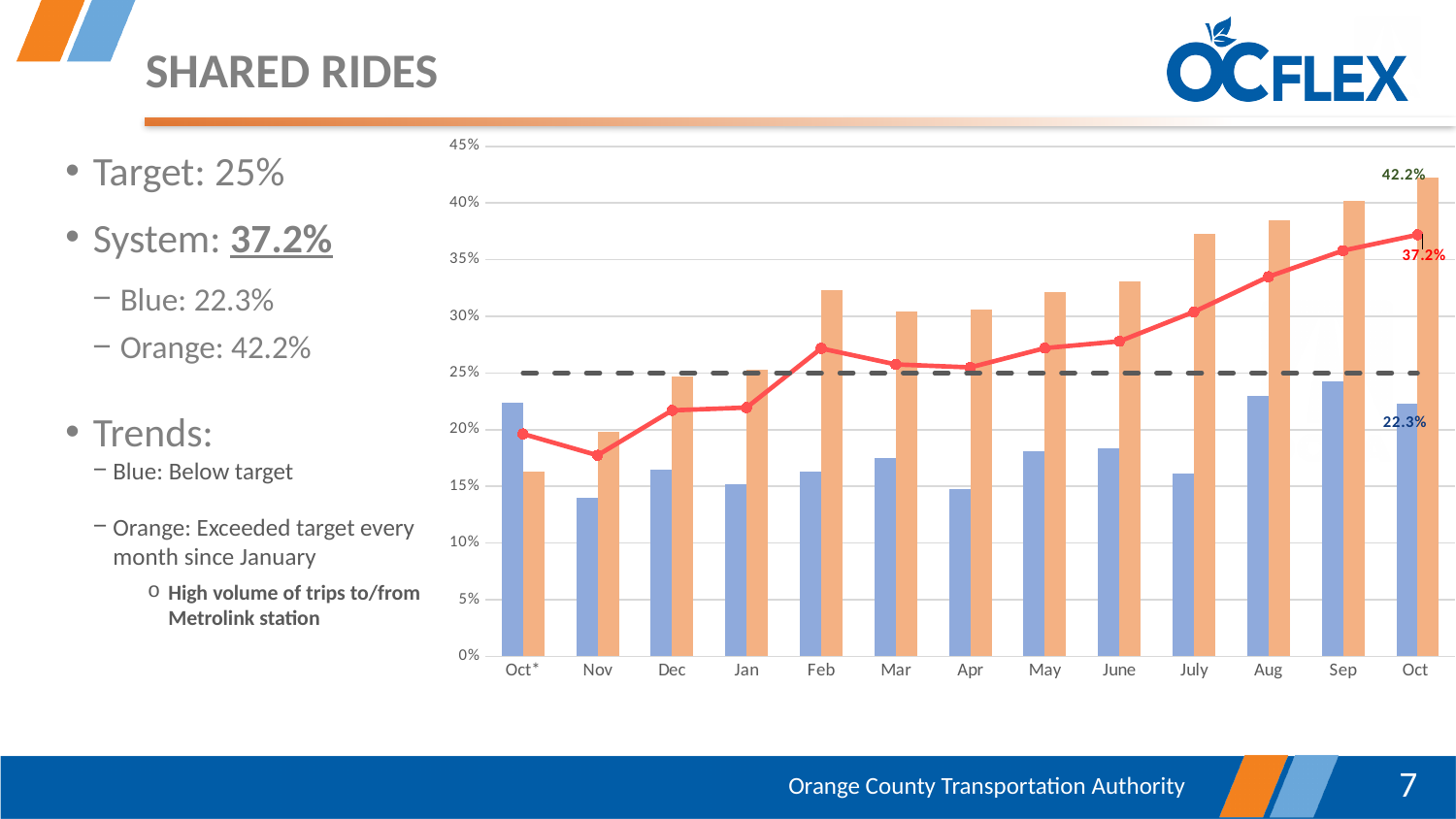
Which is larger, the orange bar for Feb or the orange bar for Mar? Feb Which month has the highest orange bar? Oct (the final month) What value does the red line reach at the final Oct in the chart? 37.2% Is the orange bar for Feb greater or less than 30%? greater What is the difference between the orange bar and the blue bar for the final Oct? 19.9 percentage points What kind of chart is shown on the slide? A bar chart with a line Which month has the lowest orange bar? Oct* How many months are shown along the x axis of the chart? 13 Is the red line value for Nov greater or less than 20%? less What is the value of the blue bar for the final Oct in the chart? 22.3% Does the red line rise or fall from July to the final Oct? Rises What is the value of the orange bar for the final Oct in the chart? 42.2%